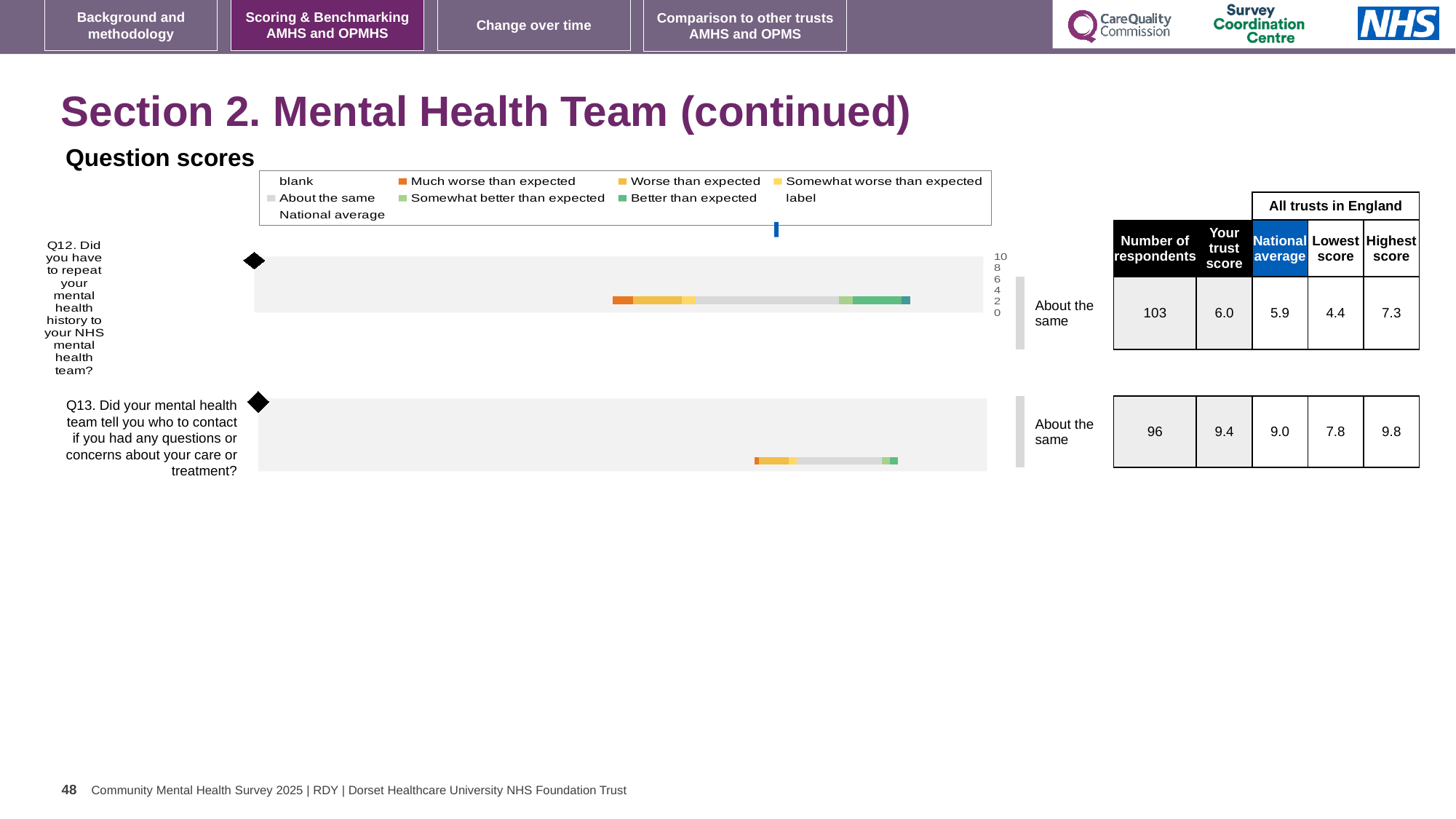
For Q12, how much higher is the trust's score than the national average? 0.1 How many respondents answered Q13? 96 For Q12, what is the national average score shown in the table? 5.9 What type of chart is used to show the question scores for Q12 and Q13? Bar chart How many entries does the legend above the charts list? 9 What benchmark category is shown next to the Q12 chart? About the same For Q12 (Did you have to repeat your mental health history to your NHS mental health team?), what is the trust's score shown in the table? 6.0 Which question has the higher trust score, Q12 or Q13? Q13 What is the lowest score among all trusts in England for Q12? 4.4 For Q13 (Did your mental health team tell you who to contact if you had any questions or concerns?), what is the trust's score? 9.4 What is the highest score among all trusts in England for Q13? 9.8 For Q13, what is the difference between the highest score and the lowest score among all trusts in England? 2.0